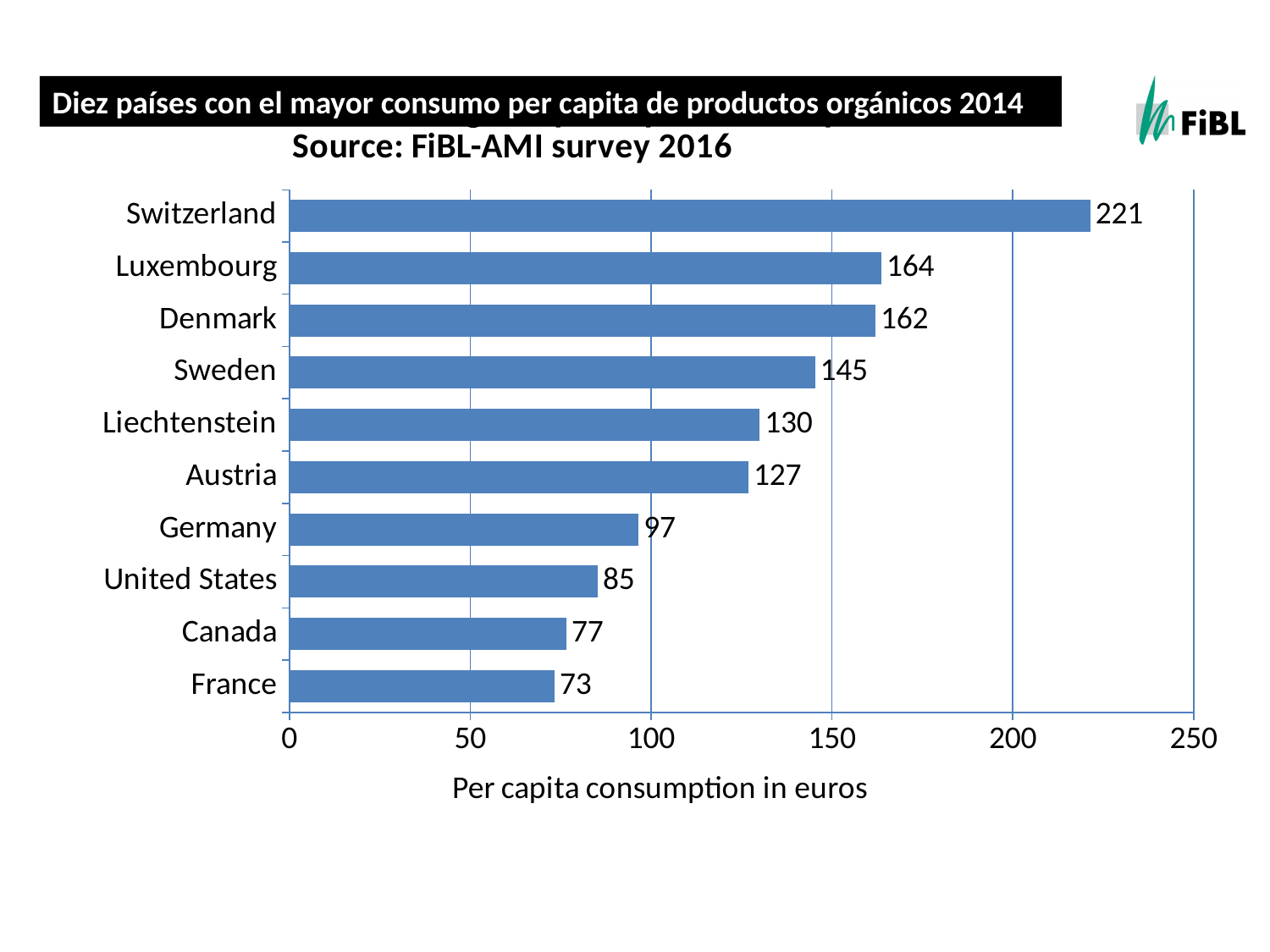
Which country has the highest per capita consumption? Switzerland What is the difference in per capita consumption between Germany and the United States? 12 Which has a higher per capita consumption, Liechtenstein or Austria? Liechtenstein Which country has the lowest per capita consumption? France What is the per capita consumption in euros for Switzerland? 221 Is the value for Denmark greater or less than 150? greater What is the per capita consumption in euros for Canada? 77 What is the label of the horizontal axis? Per capita consumption in euros What is the per capita consumption in euros for Sweden? 145 What is the difference in per capita consumption between Switzerland and Luxembourg? 57 How many countries are shown in the chart? 10 What kind of chart is shown on the slide? Bar chart